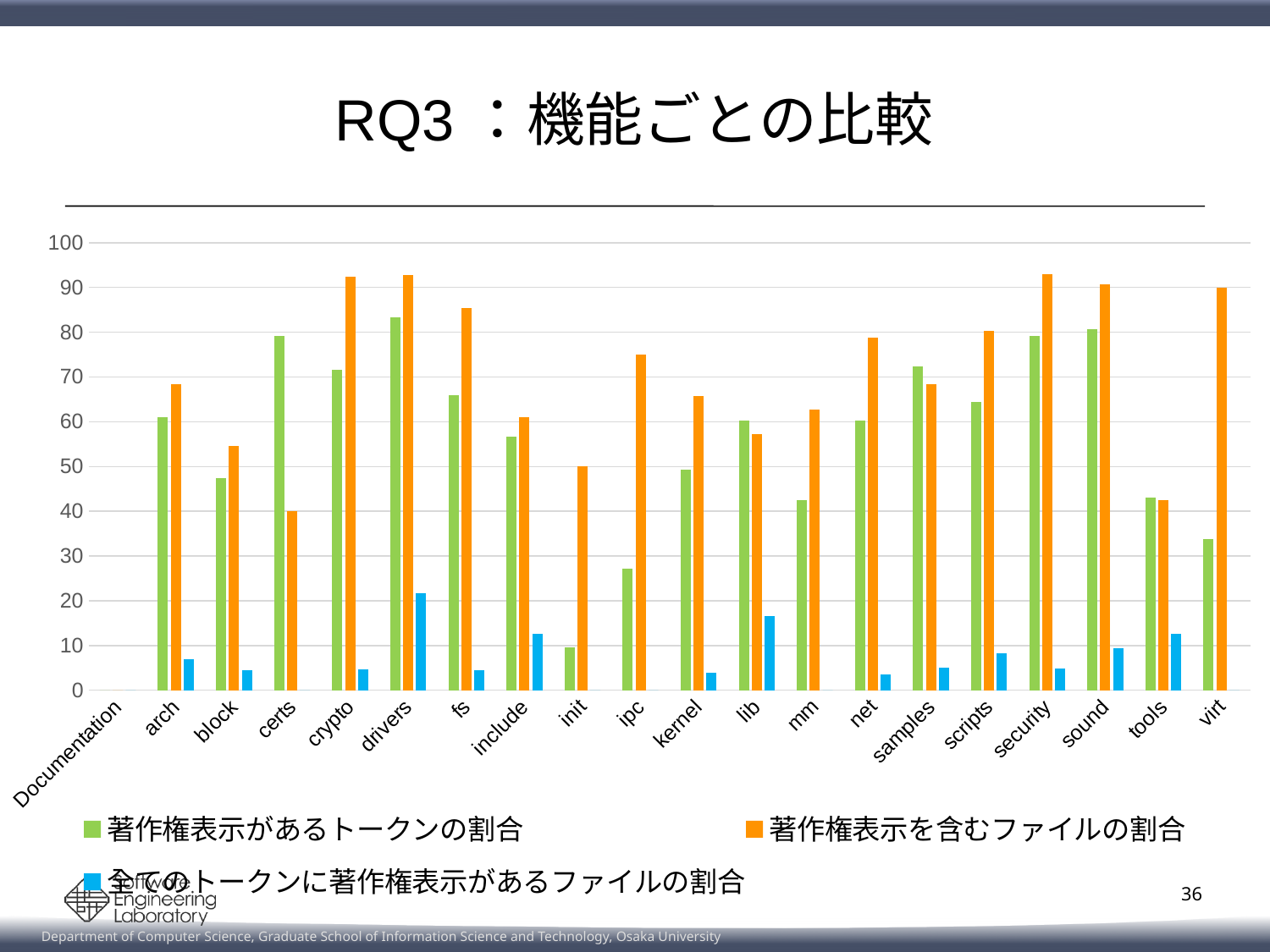
How many categories are shown along the x axis? 20 How many series does the legend list? 3 Which category has the highest value for 全てのトークンに著作権表示があるファイルの割合? drivers For ipc, which is larger: 著作権表示があるトークンの割合 or 著作権表示を含むファイルの割合? 著作権表示を含むファイルの割合 Is the value of 著作権表示を含むファイルの割合 for virt greater or less than 80? greater What kind of chart is shown on the slide? bar chart Is the value of 著作権表示があるトークンの割合 for mm greater or less than 50? less What colour represents 著作権表示を含むファイルの割合 in the chart? orange Is the value of 著作権表示を含むファイルの割合 for init greater or less than 60? less For certs, which is larger: 著作権表示があるトークンの割合 or 著作権表示を含むファイルの割合? 著作権表示があるトークンの割合